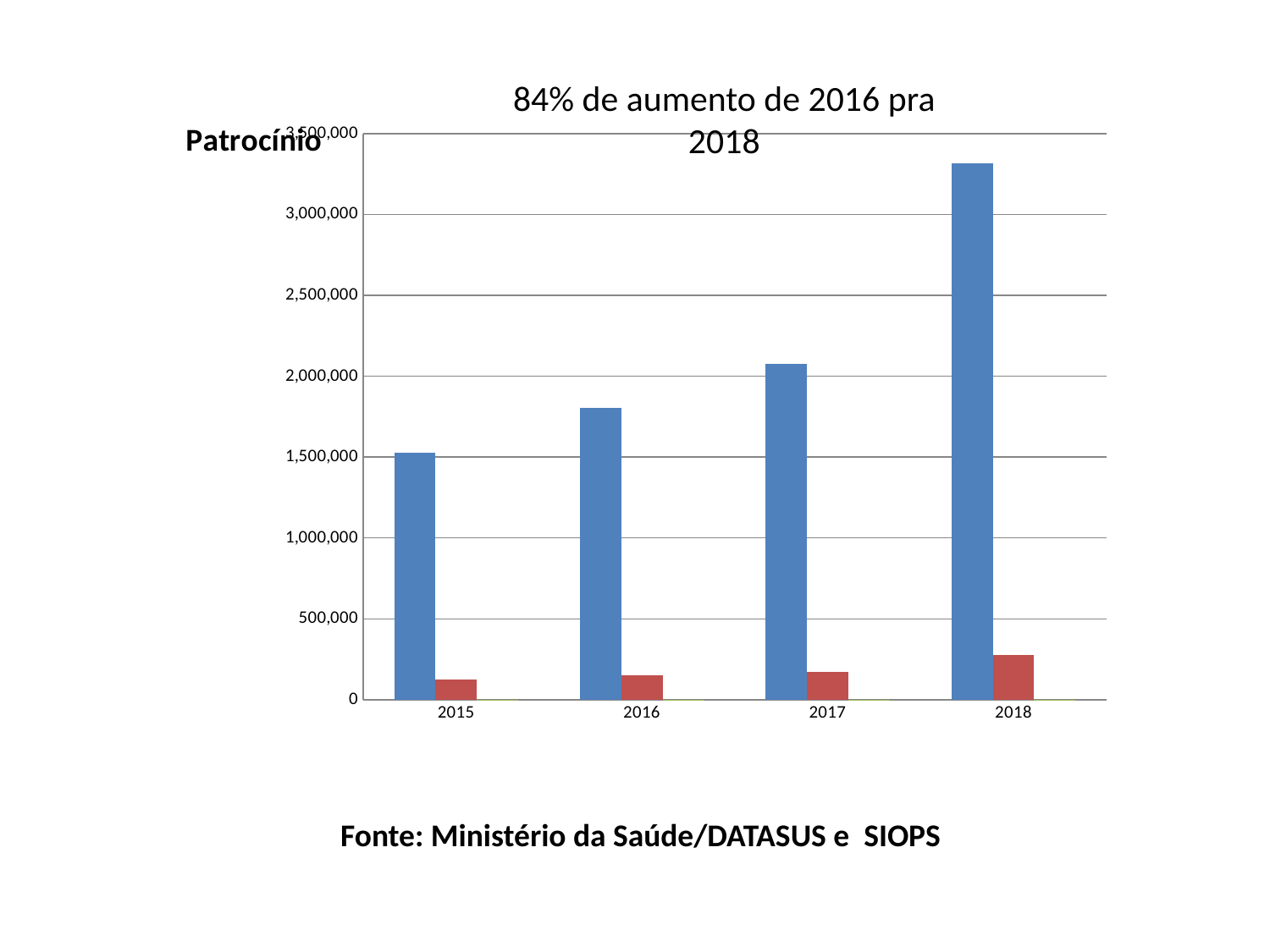
Which year has the shortest blue bar? 2015 How many years are shown on the x axis of the chart? 4 What is the title text shown above the chart? 84% de aumento de 2016 pra 2018 Is the red bar for 2018 greater or less than 500,000? less How many bars are plotted for each year in the chart? 2 Is the blue bar for 2018 greater or less than 3,000,000? greater What kind of chart is shown on the slide? bar chart Is the blue bar for 2016 greater or less than 2,000,000? less Do the blue bars rise or fall from 2015 to 2018? rise Which year has the tallest blue bar? 2018 Which is larger, the blue bar for 2017 or the blue bar for 2016? 2017 Which year has the tallest red bar? 2018